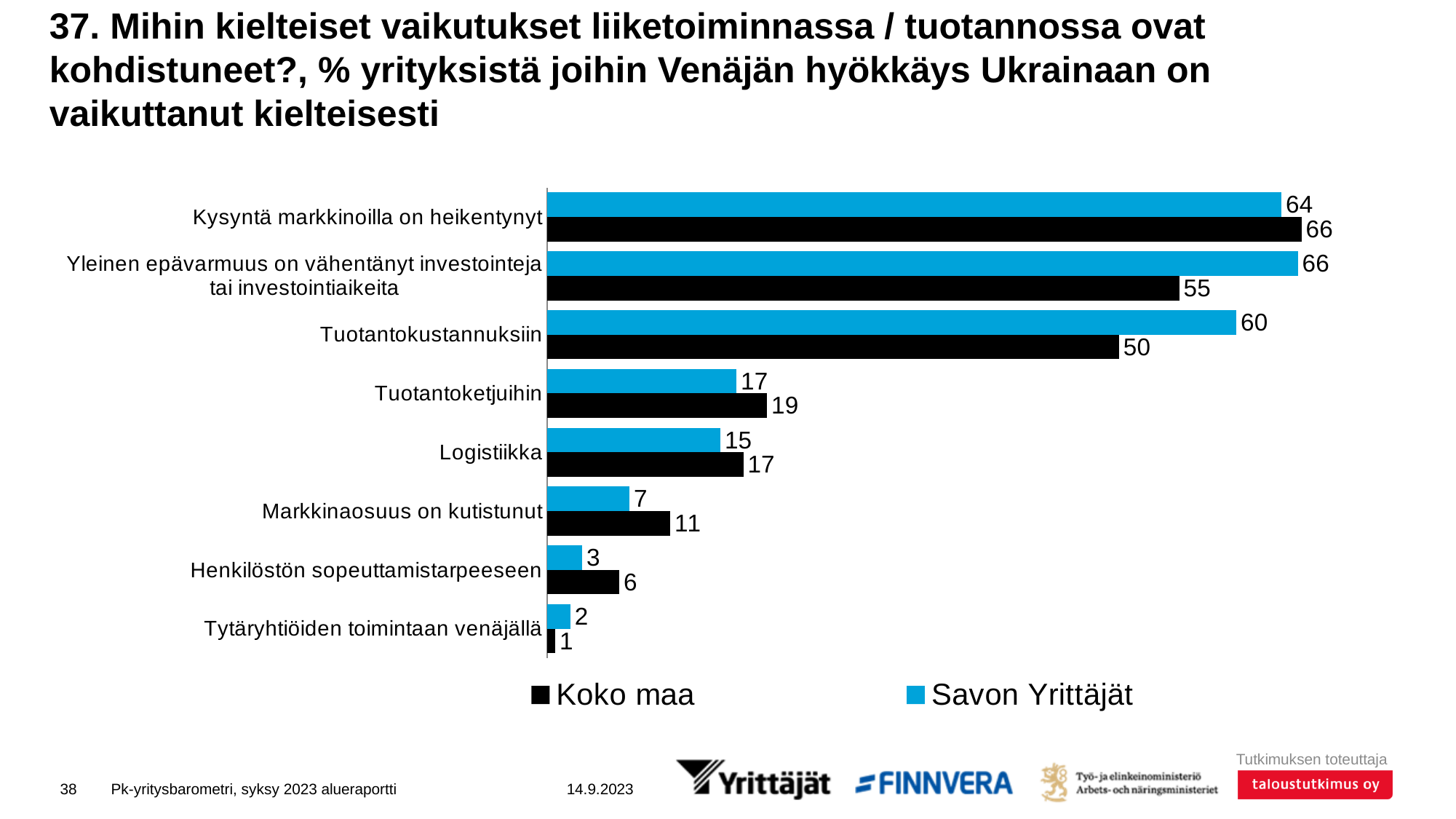
For "Logistiikka", which series has the larger value, Koko maa or Savon Yrittäjät? Koko maa What is the value for Savon Yrittäjät for "Tuotantokustannuksiin"? 60 How many series does the legend list? 2 What is the difference between the Koko maa and Savon Yrittäjät values for "Henkilöstön sopeuttamistarpeeseen"? 3 For "Yleinen epävarmuus on vähentänyt investointeja tai investointiaikeita", which series has the larger value, Koko maa or Savon Yrittäjät? Savon Yrittäjät Which category has the highest value for Koko maa? Kysyntä markkinoilla on heikentynyt Which category has the lowest value for Savon Yrittäjät? Tytäryhtiöiden toimintaan venäjällä What kind of chart is shown on the slide? Bar chart How many categories are shown in the chart? 8 What is the value for Koko maa for "Yleinen epävarmuus on vähentänyt investointeja tai investointiaikeita"? 55 What is the difference between the Savon Yrittäjät and Koko maa values for "Tuotantokustannuksiin"? 10 What is the value for Koko maa for "Markkinaosuus on kutistunut"? 11